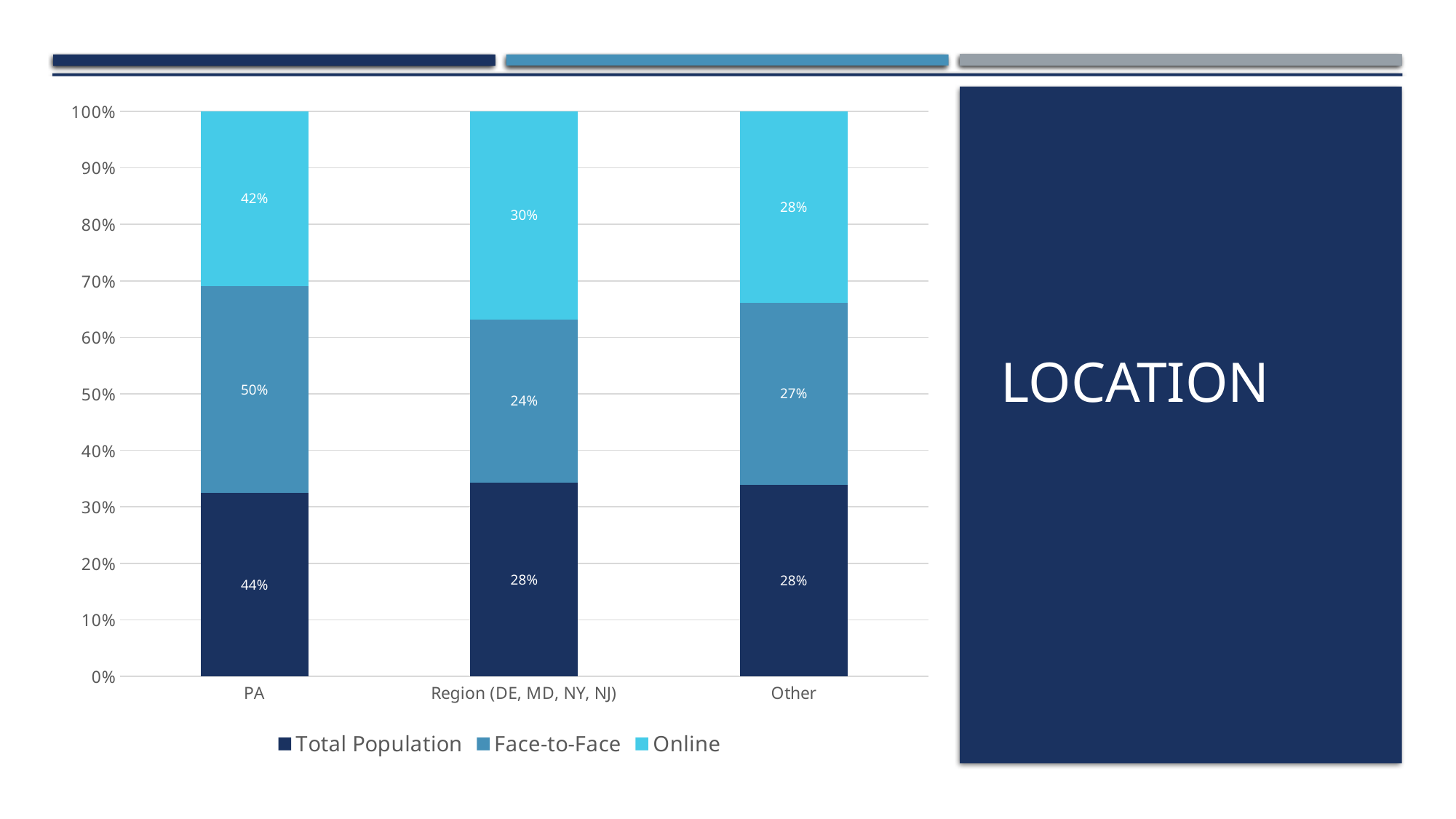
Which category has the highest Online value? PA What kind of chart is shown on the slide? Stacked bar chart What is the Online value for Other? 28% How many categories are shown on the x axis? 3 How many series does the legend list? 3 Which category has the lowest Face-to-Face value? Region (DE, MD, NY, NJ) What is the Total Population value for PA? 44% Which is larger, the Face-to-Face value for PA or the Face-to-Face value for Other? PA What is the difference between the Online values for PA and Region (DE, MD, NY, NJ)? 12% What is the Face-to-Face value for Region (DE, MD, NY, NJ)? 24% What is the difference between the Total Population values for PA and Other? 16% What is the Face-to-Face value for Other? 27%